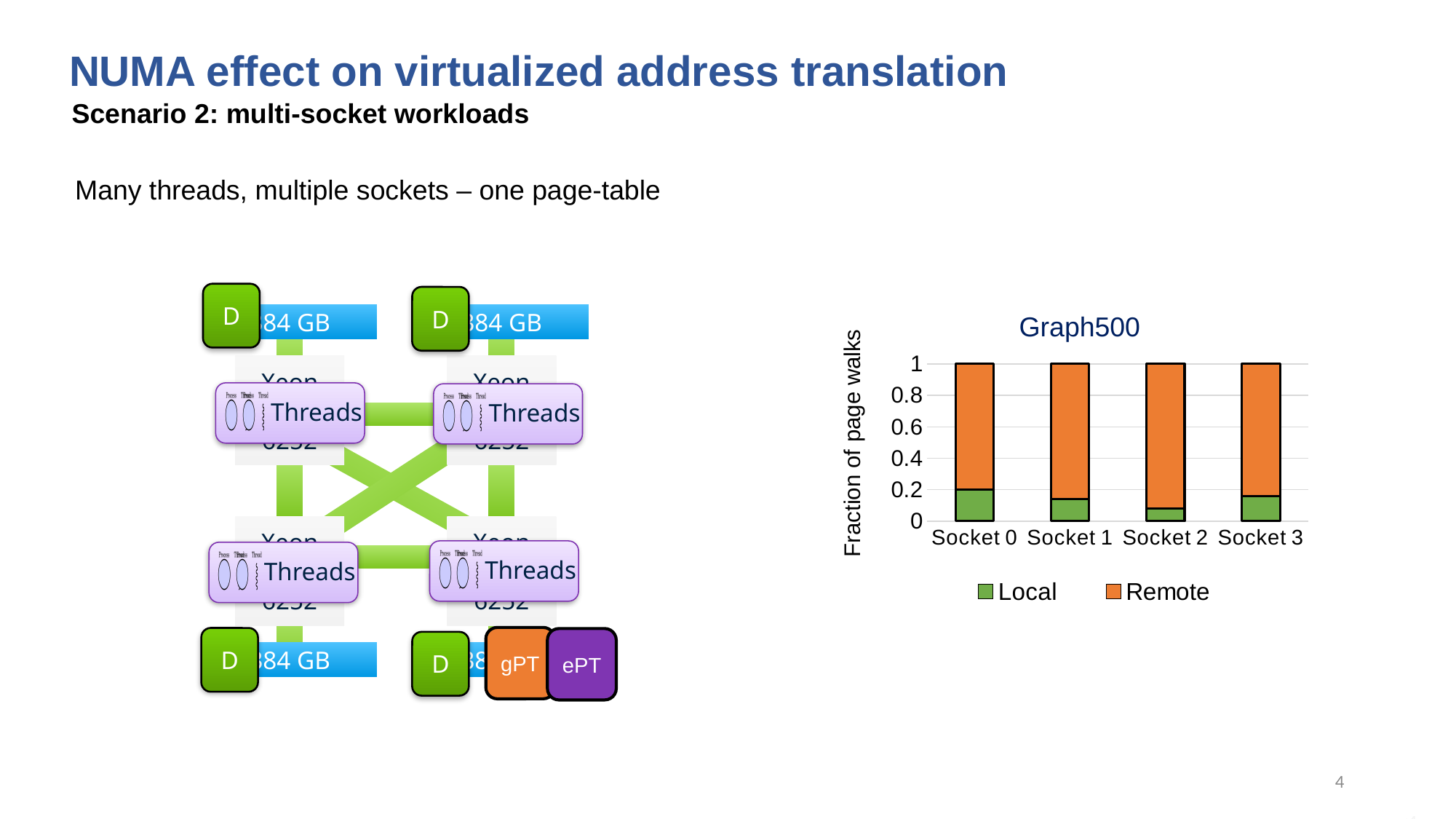
How many series does the legend of the Graph500 chart list? 2 What is the title of the chart on the slide? Graph500 In the Graph500 chart, which has the larger Local fraction: Socket 1 or Socket 2? Socket 1 In the Graph500 chart, is the Local fraction for Socket 2 greater or less than 0.2? less In the Graph500 chart, what is the total height of the stacked bar for Socket 3? 1 In the Graph500 chart, is the Local fraction for Socket 0 greater or less than 0.4? less In the Graph500 chart, is the Remote fraction for Socket 2 greater or less than 0.8? greater How many sockets (categories) are shown on the x axis of the Graph500 chart? 4 In the Graph500 chart, which socket has the highest Local fraction of page walks? Socket 0 What kind of chart is the Graph500 chart? Stacked bar chart In the Graph500 chart, which socket has the lowest Local fraction of page walks? Socket 2 What is the label of the y axis in the Graph500 chart? Fraction of page walks